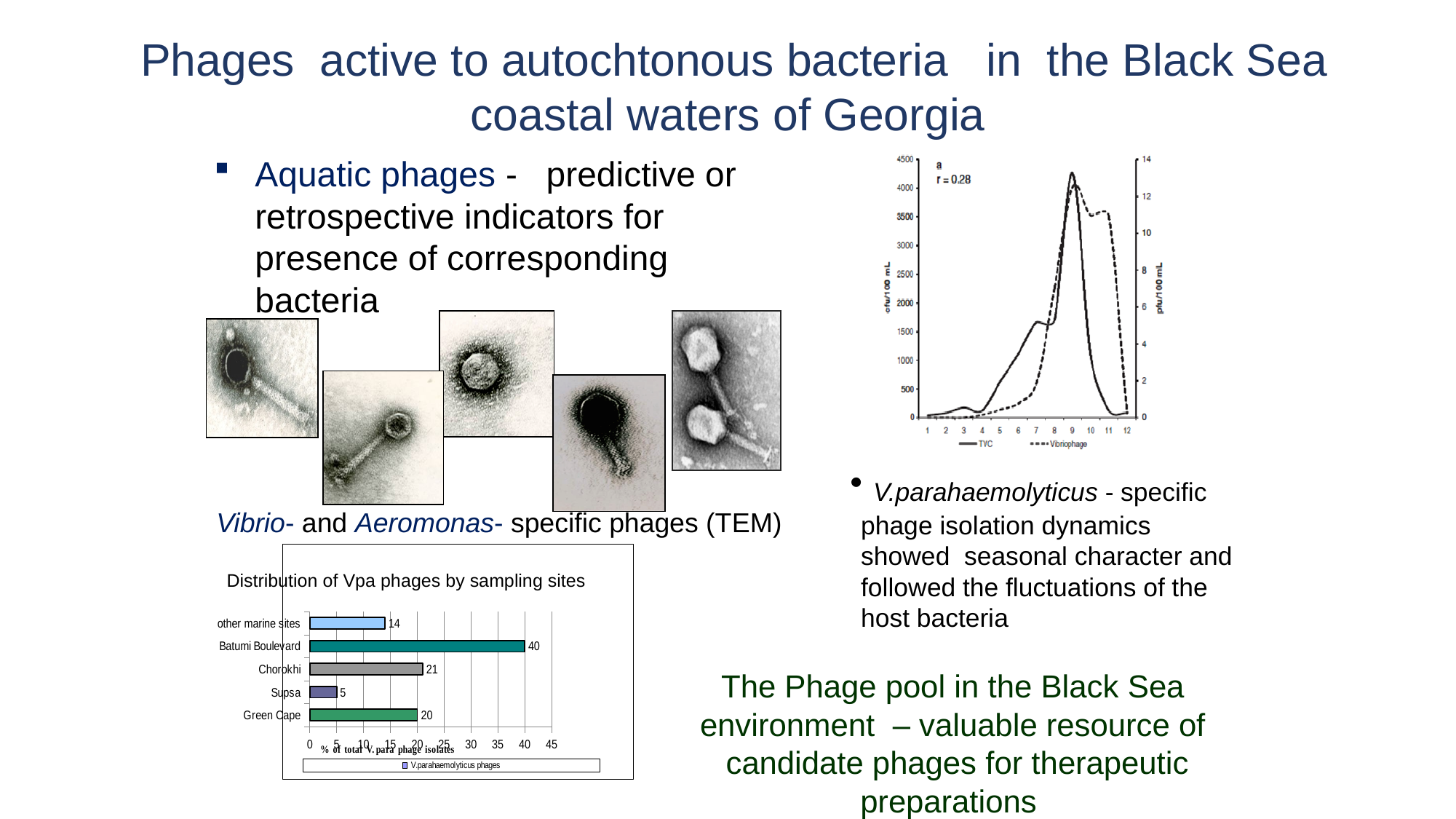
In the 'Distribution of Vpa phages by sampling sites' chart, what is the value for Chorokhi? 21 How many sampling sites are shown in the 'Distribution of Vpa phages by sampling sites' chart? 5 In the 'Distribution of Vpa phages by sampling sites' chart, which sampling site has the lowest value? Supsa What kind of chart is the 'Distribution of Vpa phages by sampling sites' chart? bar chart What are the two series named in the legend of the line chart in the top right of the slide? TVC and Vibriophage In the 'Distribution of Vpa phages by sampling sites' chart, what is the difference between the values for Batumi Boulevard and Green Cape? 20 In the 'Distribution of Vpa phages by sampling sites' chart, what is the value for Batumi Boulevard? 40 In the 'Distribution of Vpa phages by sampling sites' chart, what is the value for Supsa? 5 In the line chart in the top right of the slide, is the TVC value at month 9 greater or less than 3500? greater How many series does the legend of the line chart in the top right of the slide list? 2 In the 'Distribution of Vpa phages by sampling sites' chart, which is larger: the value for Chorokhi or the value for other marine sites? Chorokhi In the 'Distribution of Vpa phages by sampling sites' chart, which sampling site has the highest value? Batumi Boulevard